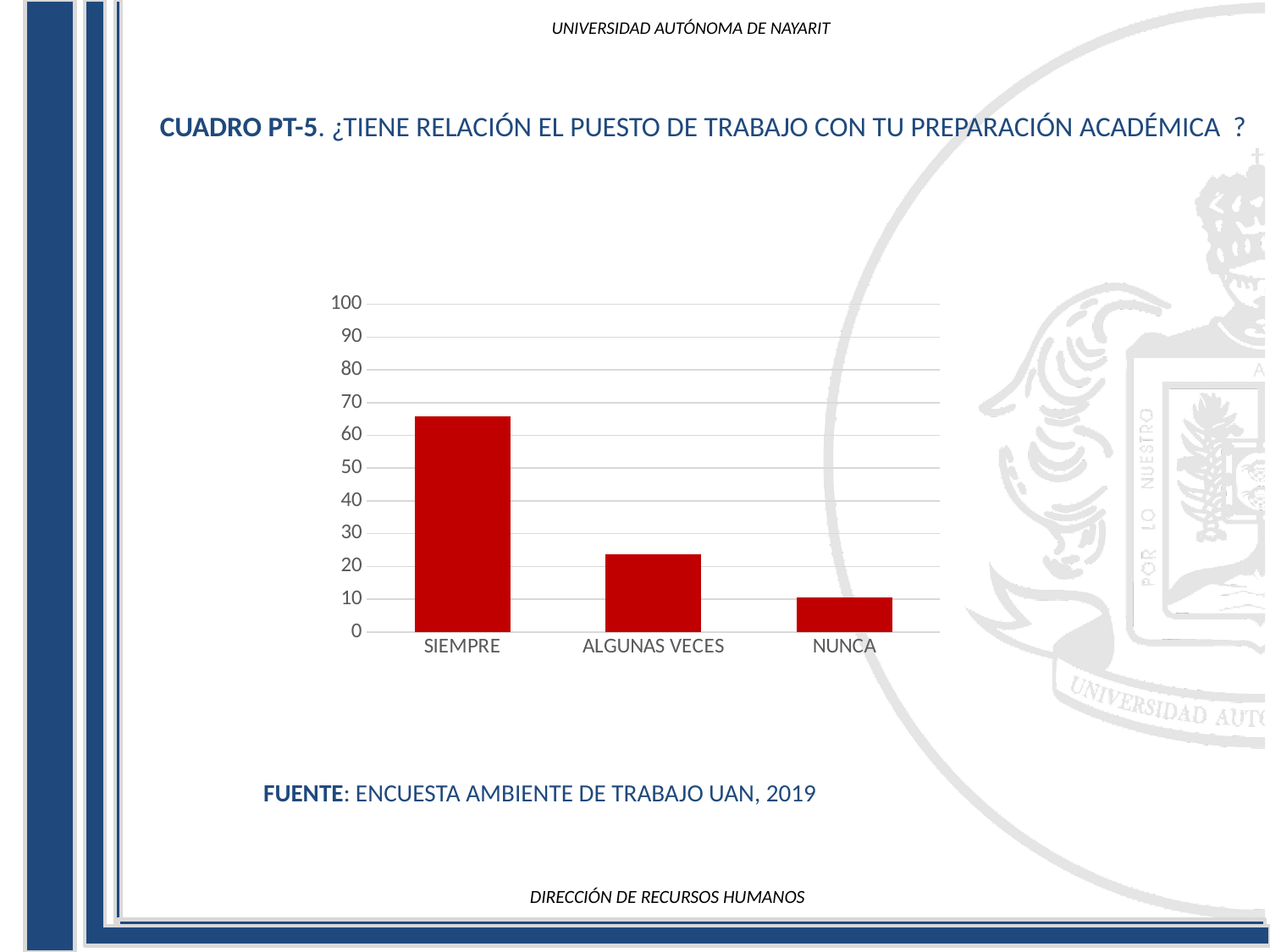
Is the value for SIEMPRE greater or less than 70? less What kind of chart is shown on the slide? bar chart Is the value for NUNCA greater or less than 20? less Which is larger, the value for SIEMPRE or the value for ALGUNAS VECES? SIEMPRE Do the bar values rise or fall from left to right along the x axis? fall Is the value for ALGUNAS VECES greater or less than 20? greater Which category has the highest bar in the chart? SIEMPRE Which category has the lowest bar in the chart? NUNCA How many categories are shown on the x axis of the chart? 3 What is the source cited below the chart? ENCUESTA AMBIENTE DE TRABAJO UAN, 2019